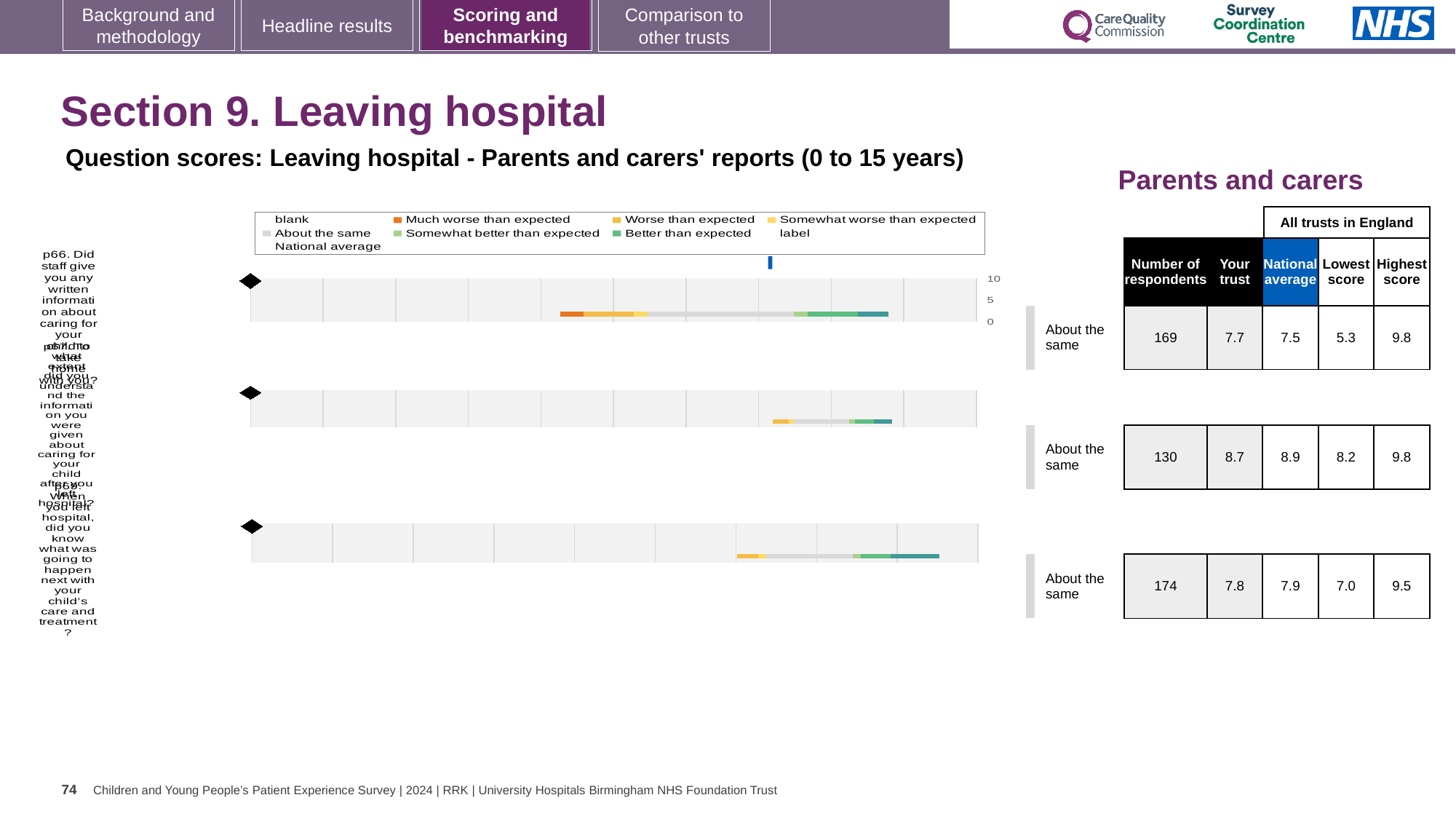
For the bottom chart row, what is the difference between the highest score and the lowest score? 2.5 What kind of chart is used to show the question scores? Bar chart What is the 'Your trust' score for the top chart row (question p66 about written information on caring for your child)? 7.7 What benchmark category is given for all three question rows? About the same For the top chart row, which is larger: the 'Your trust' score or the national average? Your trust (7.7) For the middle chart row, which is larger: the 'Your trust' score or the national average? National average (8.9) Which chart row has the lowest 'Lowest score' among all trusts in England? The top row (5.3) What colour does the legend use for 'Much worse than expected'? Orange How many question rows are plotted on the slide? 3 What is the national average score for the middle chart row? 8.9 How many respondents are shown for the bottom chart row (question p68)? 174 Which chart row has the highest 'Your trust' score? The middle row (8.7)